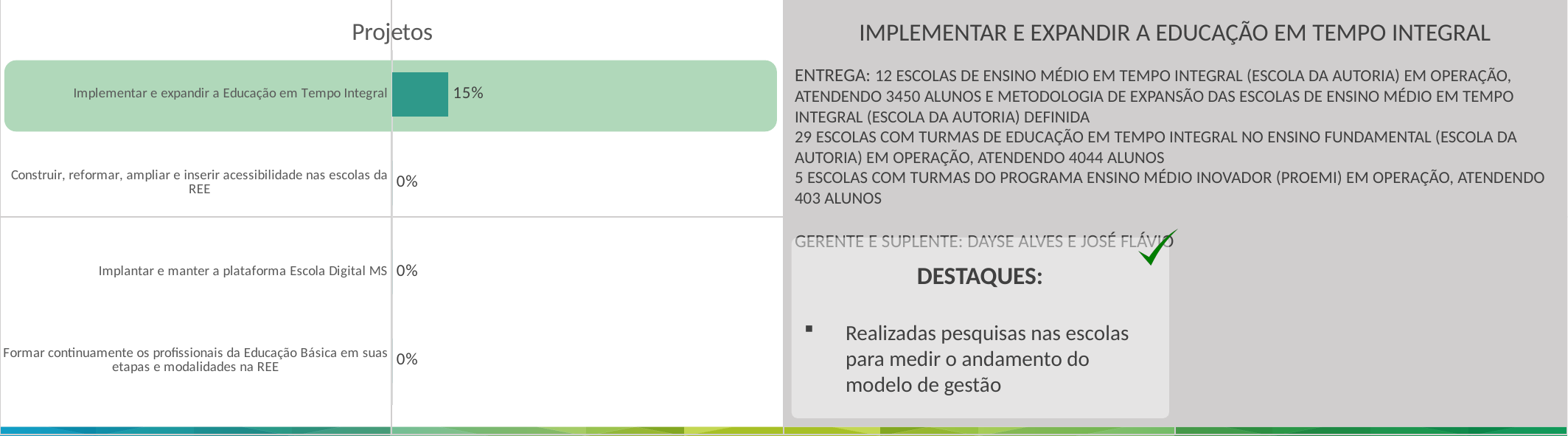
How many categories does the "Projetos" chart show? 4 Which category has the highest value in the "Projetos" chart? Implementar e expandir a Educação em Tempo Integral What is the value for "Implantar e manter a plataforma Escola Digital MS" in the "Projetos" chart? 0% What is the value for "Implementar e expandir a Educação em Tempo Integral" in the "Projetos" chart? 15% What is the difference between the value for "Implementar e expandir a Educação em Tempo Integral" and the value for "Implantar e manter a plataforma Escola Digital MS" in the "Projetos" chart? 15% How many categories in the "Projetos" chart have a value of 0%? 3 What is the value for "Construir, reformar, ampliar e inserir acessibilidade nas escolas da REE" in the "Projetos" chart? 0% What is the title of the chart on the slide? Projetos What kind of chart is shown under the title "Projetos"? bar chart What is the value for "Formar continuamente os profissionais da Educação Básica em suas etapas e modalidades na REE" in the "Projetos" chart? 0% In the "Projetos" chart, which is larger: the value for "Implementar e expandir a Educação em Tempo Integral" or the value for "Construir, reformar, ampliar e inserir acessibilidade nas escolas da REE"? Implementar e expandir a Educação em Tempo Integral Which category in the "Projetos" chart is highlighted with a green background? Implementar e expandir a Educação em Tempo Integral